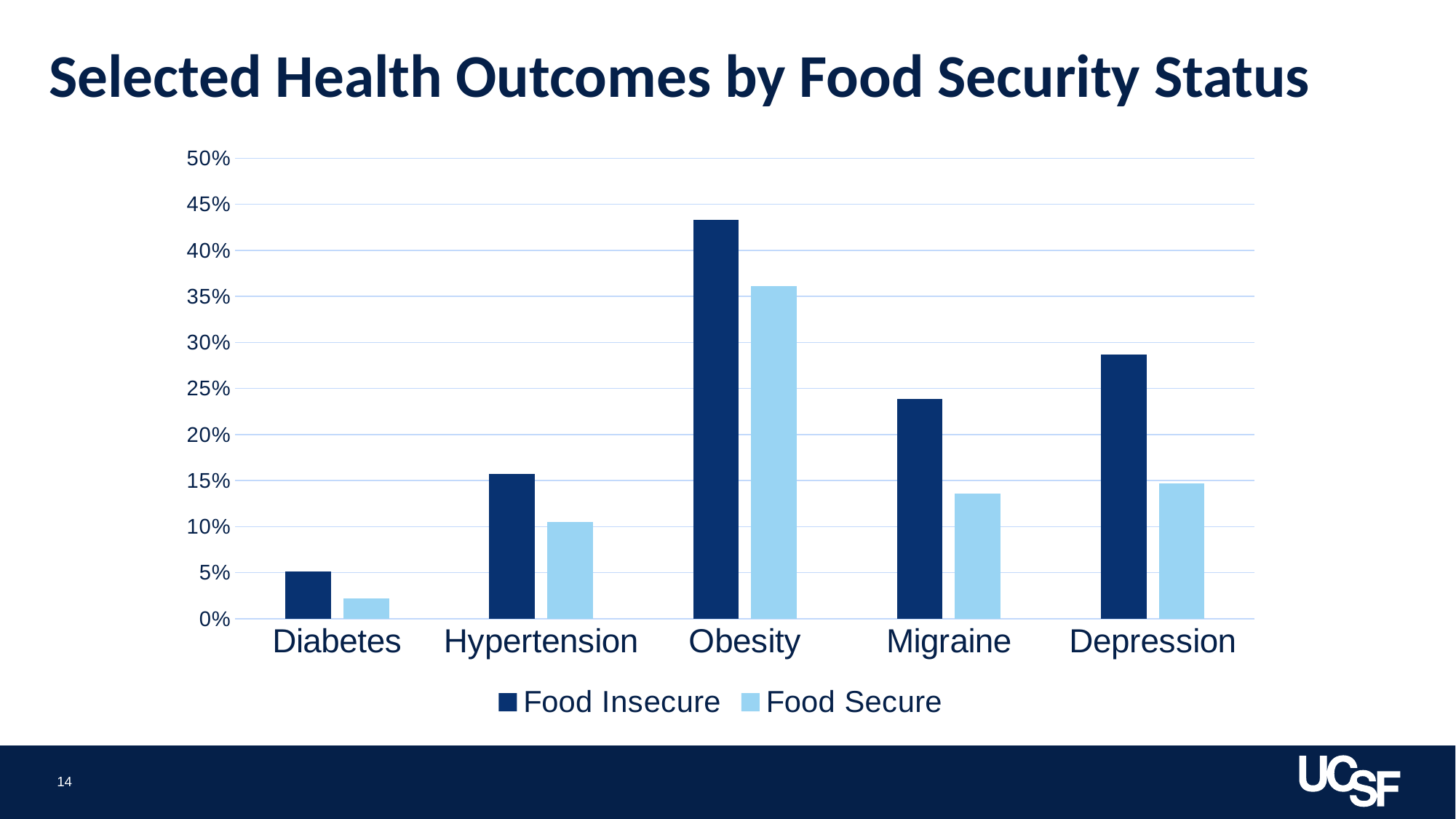
What type of chart is shown on the slide? bar chart Is the Food Insecure value for Obesity greater or less than 40%? greater Which health outcome has the lowest Food Secure value? Diabetes Is the Food Secure value for Obesity greater or less than 30%? greater How many health outcome categories are shown on the x axis? 5 Is the Food Insecure value for Migraine greater or less than 20%? greater What is the title of the chart? Selected Health Outcomes by Food Security Status For Depression, which series has the larger value, Food Insecure or Food Secure? Food Insecure How many series does the legend list? 2 Which health outcome has the highest Food Insecure value? Obesity